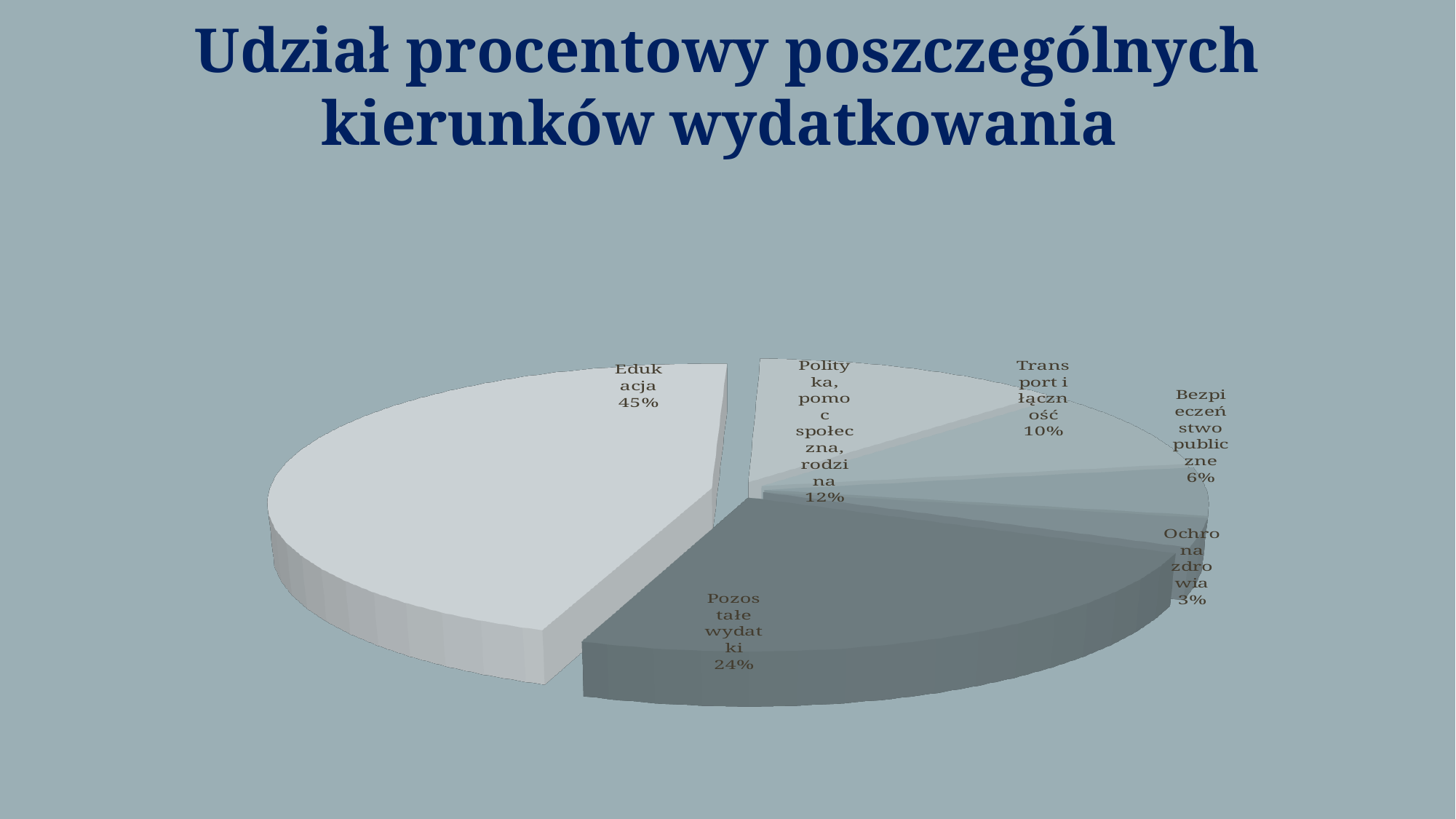
How many categories (slices) does the pie chart have? 6 What is the share for Polityka, pomoc społeczna, rodzina? 12% Which is larger, the share for Transport i łączność or the share for Bezpieczeństwo publiczne? Transport i łączność Which category has the largest share of the pie? Edukacja What is the share for Edukacja? 45% What is the difference in percentage points between Edukacja and Pozostałe wydatki? 21 What is the share for Bezpieczeństwo publiczne? 6% What is the share for Transport i łączność? 10% What kind of chart is shown on the slide? pie chart What is the share for Ochrona zdrowia? 3% Which category has the smallest share of the pie? Ochrona zdrowia What is the share for Pozostałe wydatki? 24%